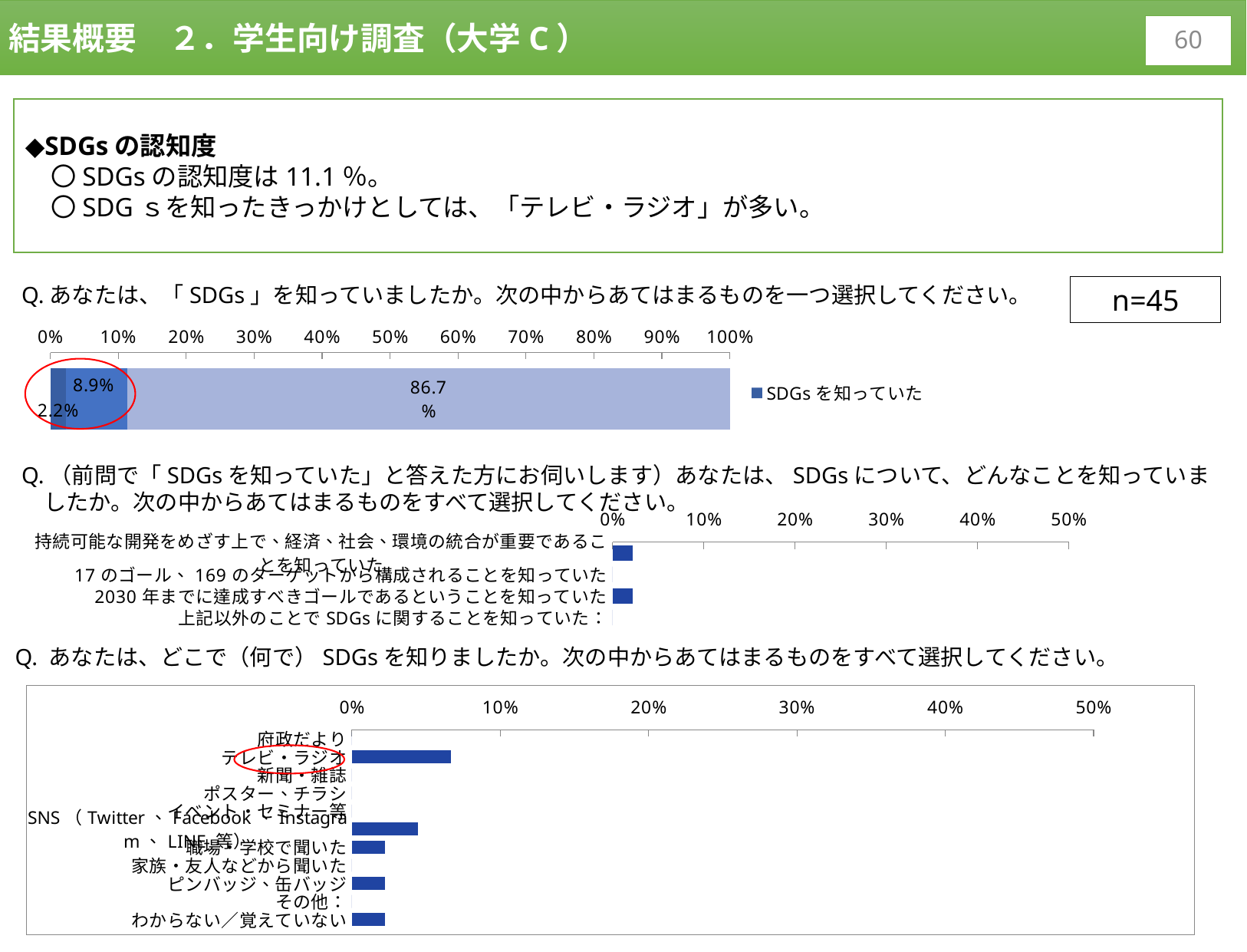
In the bottom chart (where did you learn about SDGs), which category has the highest value? テレビ・ラジオ In the bottom chart, is the value for テレビ・ラジオ greater or less than 10%? less In the top stacked bar chart, what is the difference between the 86.7% segment and the 8.9% segment? 77.8% How many categories are listed in the middle chart (what they knew about SDGs)? 4 In the top stacked bar chart, what is the value of the middle segment? 8.9% How many categories are listed in the bottom chart? 11 In the top stacked bar chart, what is the combined value of the 2.2% and 8.9% segments? 11.1% In the top stacked bar chart, what is the value of the largest segment? 86.7% In the bottom chart, which is larger: テレビ・ラジオ or SNS（Twitter、Facebook、Instagram、LINE等）? テレビ・ラジオ In the top chart, what is the legend entry shown? SDGsを知っていた In the top stacked bar chart, what is the value of the smallest segment? 2.2% What kind of chart is the top chart on the slide? bar chart